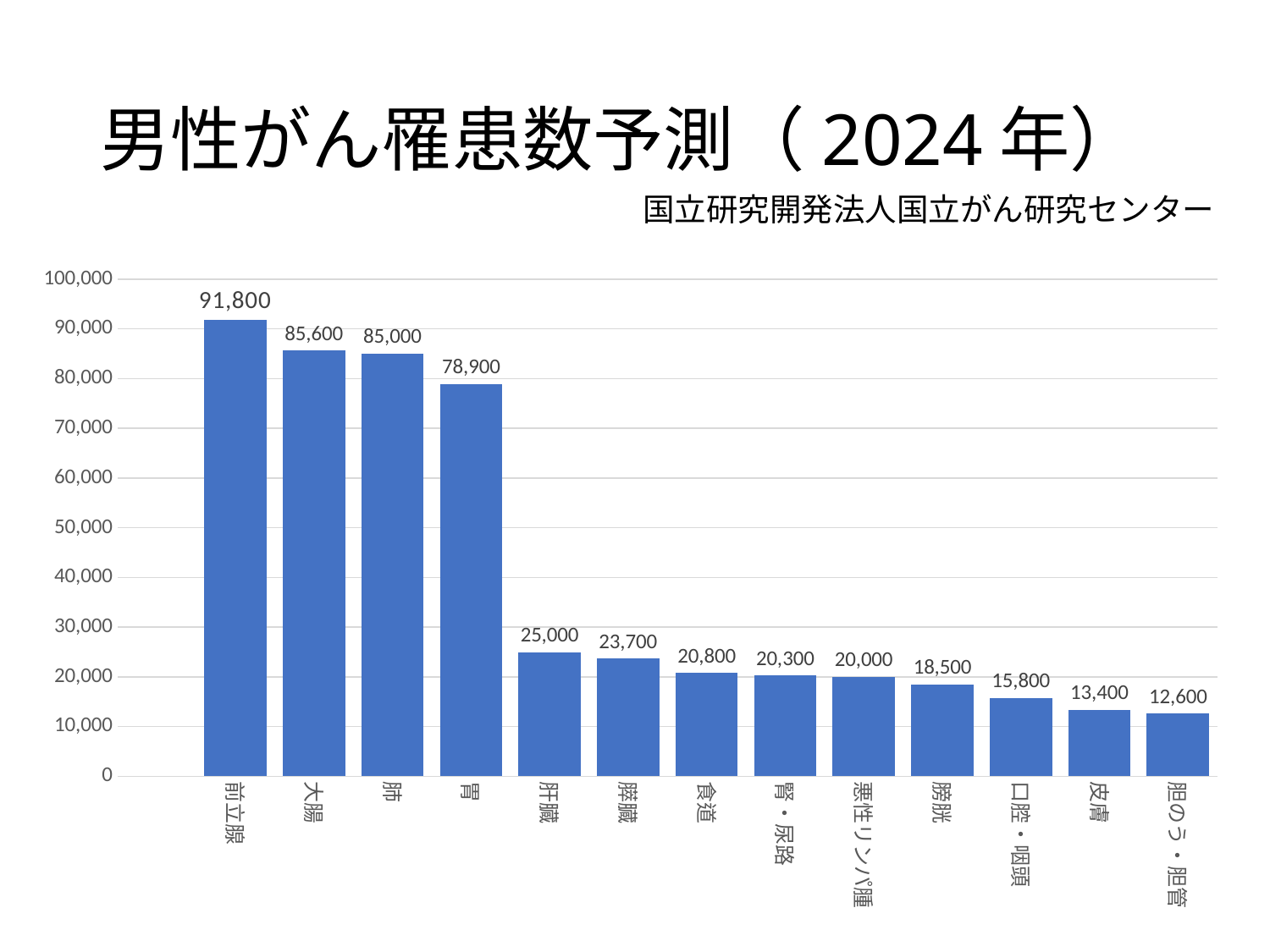
How many categories are shown on the x axis? 13 What is the value shown for 膀胱 (bladder)? 18,500 What kind of chart is shown on the slide? bar chart Which category has the lowest value? 胆のう・胆管 What is the difference between the values for 前立腺 and 胃? 12,900 What is the value shown for 胃 (stomach)? 78,900 Which is larger, the value for 肝臓 or the value for 膵臓? 肝臓 Which category has the highest value? 前立腺 What is the difference between the values for 大腸 and 肺? 600 Is the value for 食道 greater or less than 30,000? less What is the title of the slide? 男性がん罹患数予測（2024年） What is the predicted number of cases for 前立腺 (prostate)? 91,800